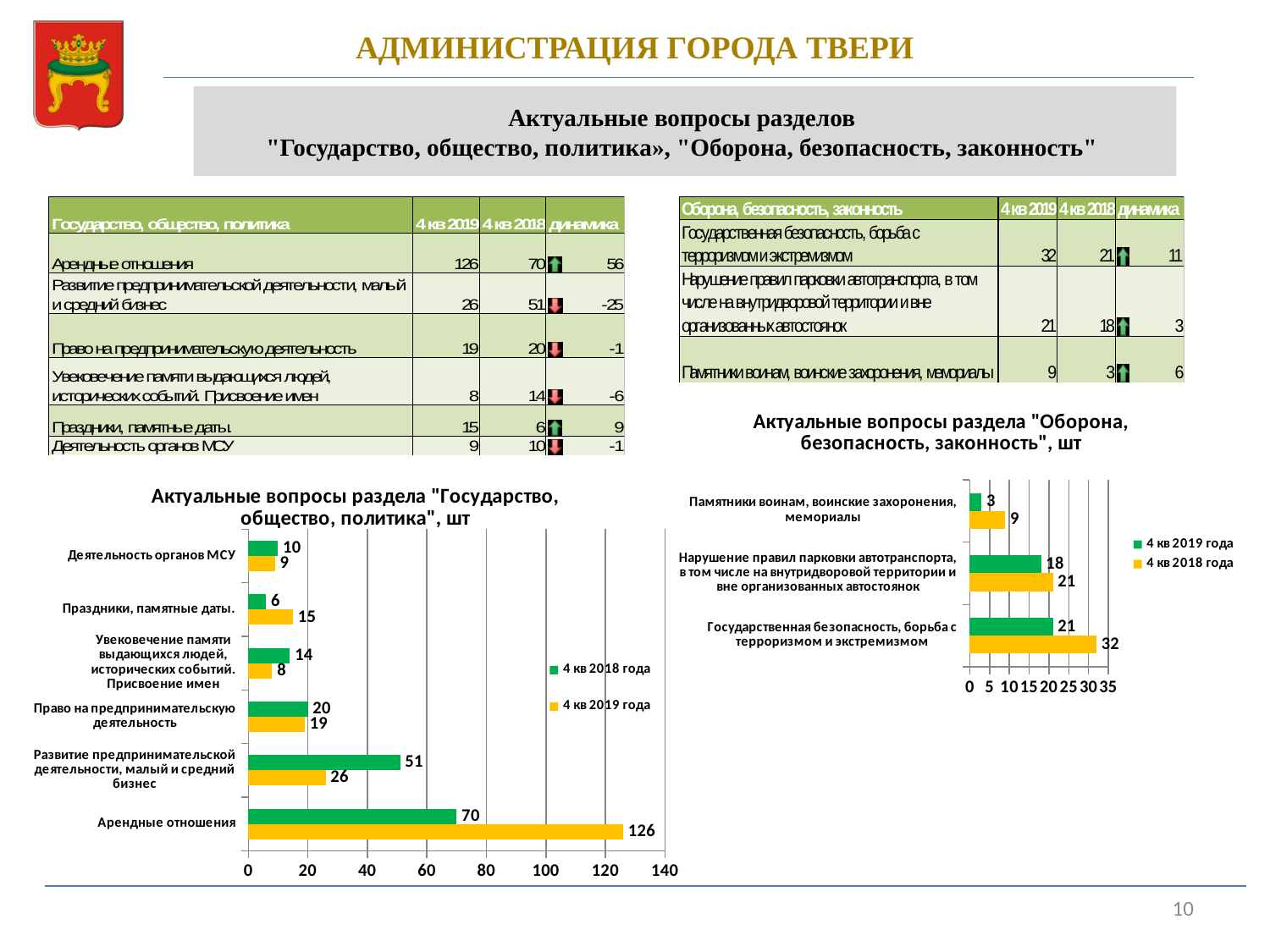
In the chart "Актуальные вопросы раздела "Государство, общество, политика", шт", which is larger for Увековечение памяти выдающихся людей, исторических событий. Присвоение имен: the 4 кв 2018 года value or the 4 кв 2019 года value? 4 кв 2018 года In the chart "Актуальные вопросы раздела "Государство, общество, политика", шт", what is the difference between the 4 кв 2019 года and 4 кв 2018 года values for Арендные отношения? 56 How many series does the legend of the chart "Актуальные вопросы раздела "Оборона, безопасность, законность", шт" list? 2 In the chart "Актуальные вопросы раздела "Государство, общество, политика", шт", what is the value for Арендные отношения in 4 кв 2019 года? 126 In the chart "Актуальные вопросы раздела "Государство, общество, политика", шт", what is the value for Праздники, памятные даты in 4 кв 2019 года? 15 In the chart "Актуальные вопросы раздела "Оборона, безопасность, законность", шт", which category has the highest value overall? Государственная безопасность, борьба с терроризмом и экстремизмом How many categories are shown in the chart "Актуальные вопросы раздела "Государство, общество, политика", шт"? 6 What kind of chart is the chart titled "Актуальные вопросы раздела "Государство, общество, политика", шт"? bar chart In the chart "Актуальные вопросы раздела "Государство, общество, политика", шт", which category has the highest value for 4 кв 2019 года? Арендные отношения In the chart "Актуальные вопросы раздела "Государство, общество, политика", шт", what is the value for Развитие предпринимательской деятельности, малый и средний бизнес in 4 кв 2018 года? 51 How many categories are shown in the chart "Актуальные вопросы раздела "Оборона, безопасность, законность", шт"? 3 In the chart "Актуальные вопросы раздела "Государство, общество, политика", шт", which category has the lowest value for 4 кв 2018 года? Праздники, памятные даты